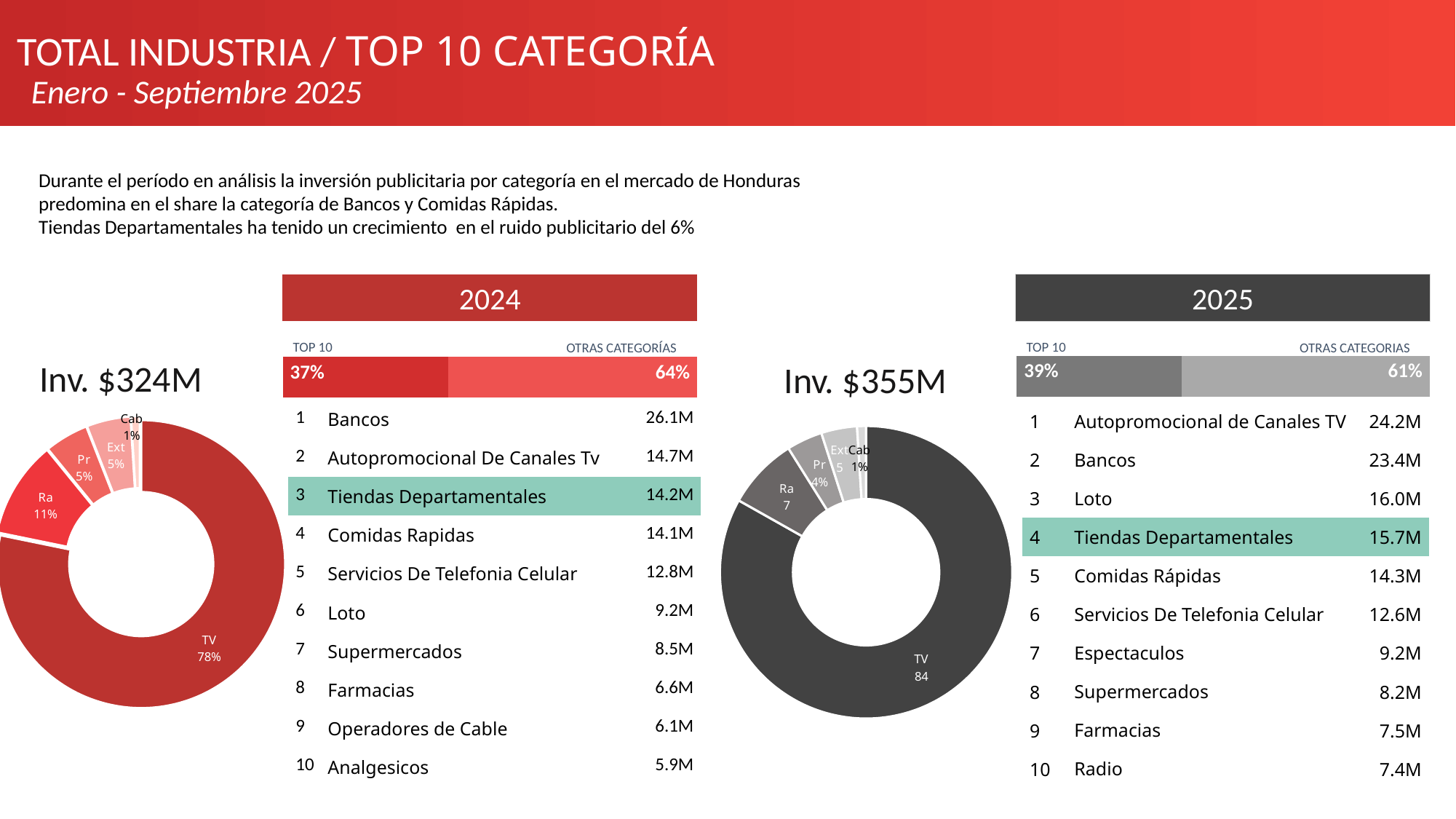
In the 2024 donut chart on the left, what share does Ra have? 11% In the 2024 donut chart on the left, how many slices are labelled? 5 In the 2024 donut chart on the left, what share does TV have? 78% In the 2024 donut chart on the left, which is larger, Ra or Pr? Ra In the 2025 donut chart on the right, what value is shown for Pr? 4% In the 2024 donut chart on the left, which slice is the largest? TV In the 2024 stacked bar, what percentage is shown for TOP 10? 37% What kind of chart is used to show the media split under Inv. $324M? Donut chart In the 2025 stacked bar, what percentage is shown for OTRAS CATEGORIAS? 61% In the 2025 donut chart on the right, which slice is the smallest? Cab In the 2025 donut chart on the right, what value is shown for TV? 84 What is the difference between the TOP 10 share in the 2025 bar and the TOP 10 share in the 2024 bar? 2%